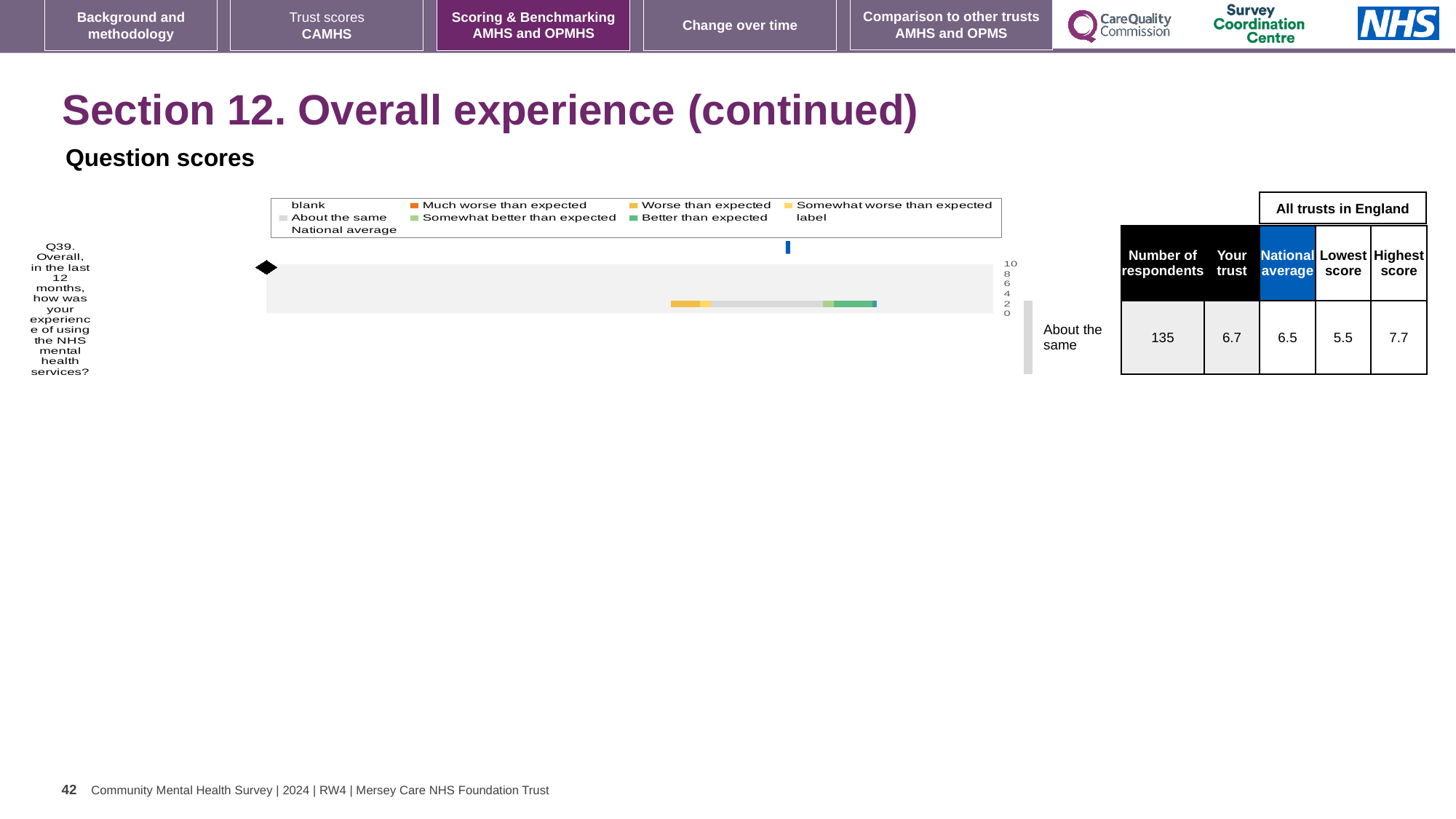
What is the difference between the 'Your trust' score and the national average for Q39? 0.2 What is the lowest score among all trusts in England for Q39? 5.5 Which is larger for Q39, the 'Your trust' score or the national average? Your trust What kind of chart is shown on the slide? bar chart What is the national average score for Q39? 6.5 How many questions are plotted on the chart? 1 Is the 'Your trust' score for Q39 greater or less than 6? greater How many respondents answered Q39? 135 What is the difference between the highest and lowest scores for Q39? 2.2 What benchmark category is the trust's Q39 score placed in? About the same What is the 'Your trust' score for Q39? 6.7 What is the highest score among all trusts in England for Q39? 7.7